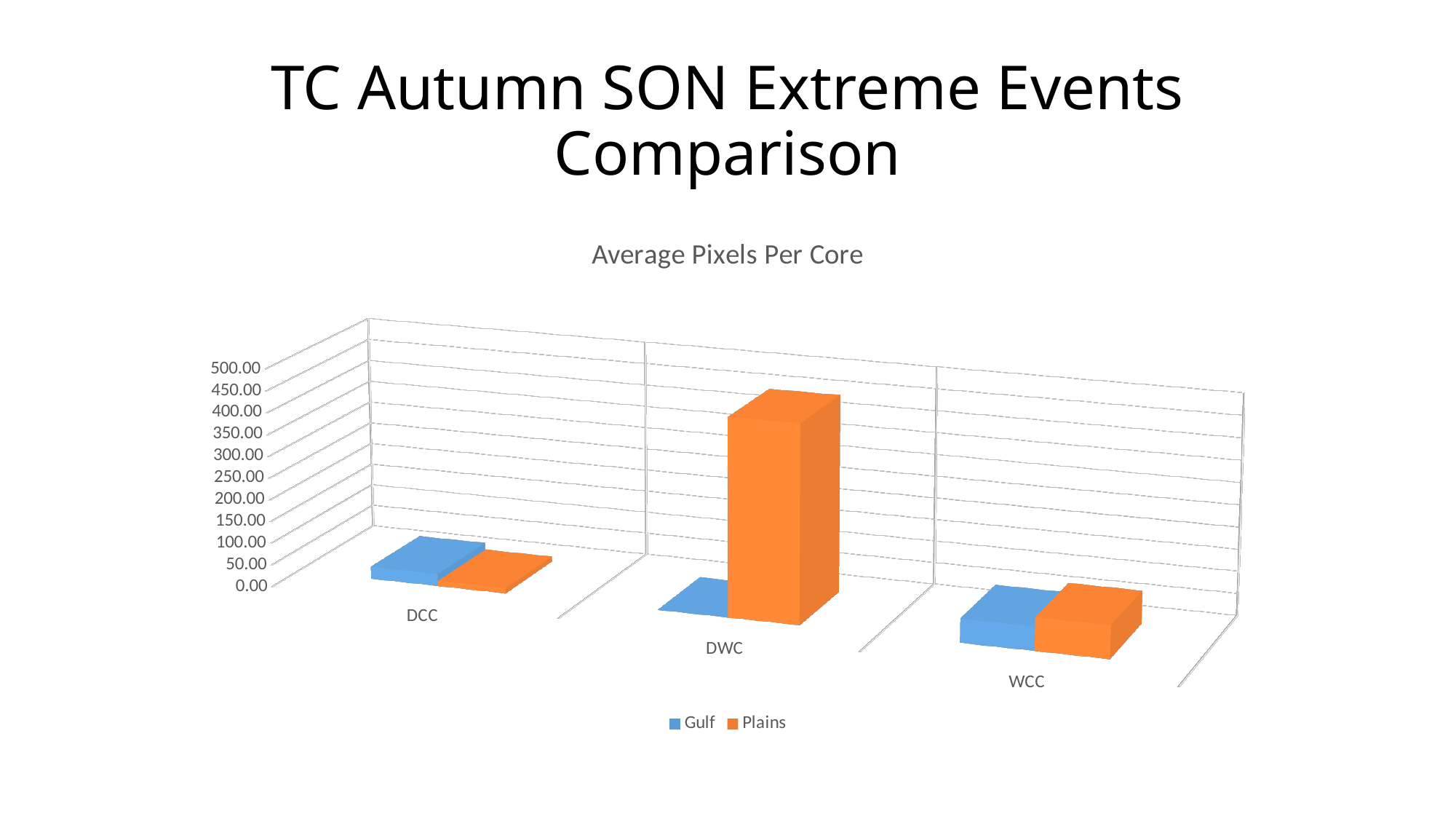
For DWC, which series has the larger value, Gulf or Plains? Plains Which category has the highest Plains value? DWC Is the Gulf value for DCC greater or less than 150.00? less Is the Plains value for WCC greater or less than 200.00? less Is the Plains value for DWC greater or less than 300.00? greater Which series are listed in the legend? Gulf and Plains What is the title of the chart? Average Pixels Per Core How many series does the legend list? 2 Which category has the highest value across both series? DWC What kind of chart is shown on the slide? bar chart How many categories are shown on the x axis? 3